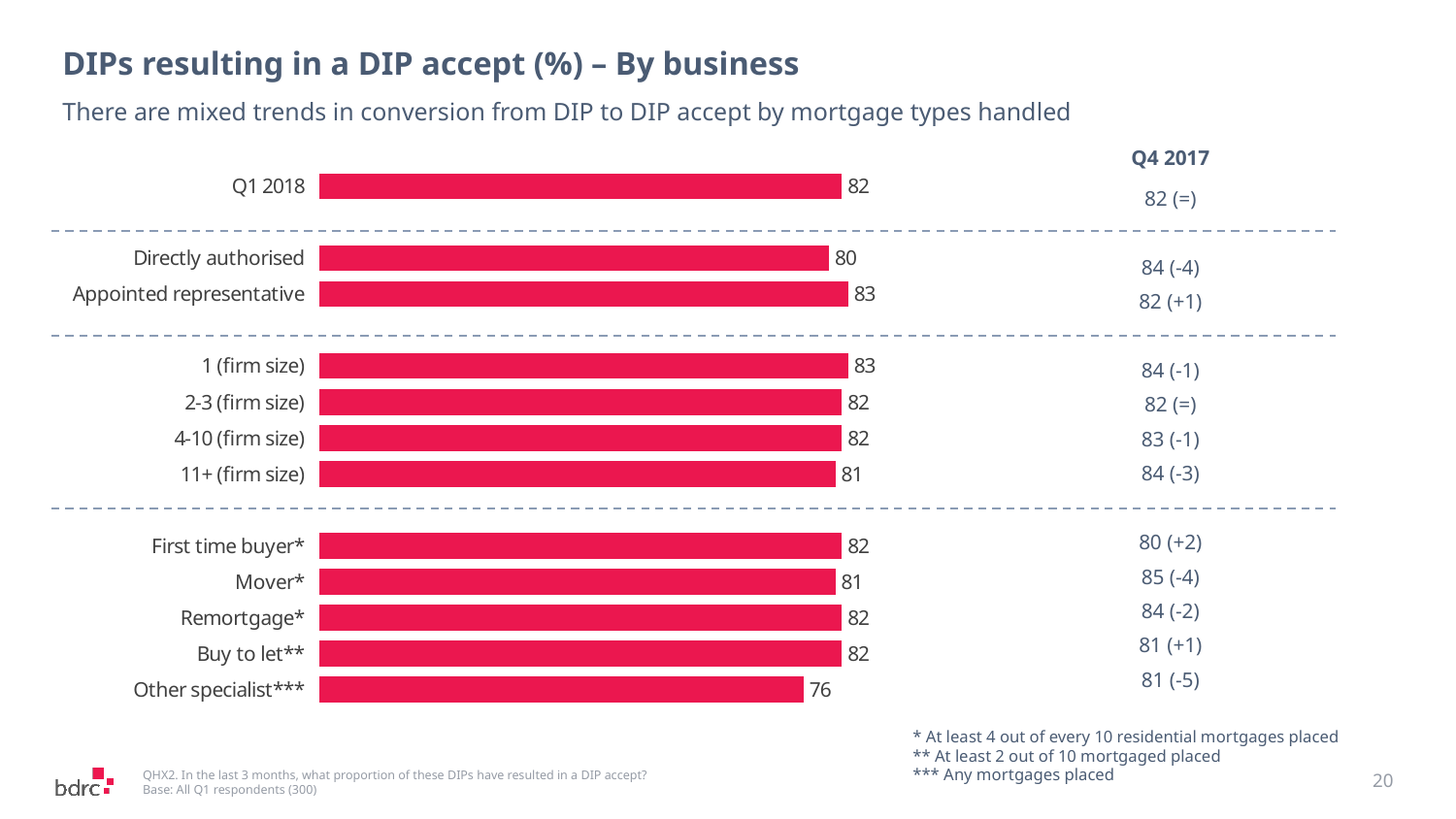
How many bars are plotted in the chart? 12 What is the value for Directly authorised? 80 Which category has the lowest value in the chart? Other specialist*** Which is larger, the value for 1 (firm size) or the value for 11+ (firm size)? 1 (firm size) What is the value for Q1 2018 overall? 82 What is the Q4 2017 value shown for Mover*? 85 (-4) What is the difference between the values for Appointed representative and Directly authorised? 3 What kind of chart is shown on the slide? Bar chart What is the value for Other specialist*** in the chart? 76 What is the value for 11+ (firm size)? 81 What is the difference between the values for First time buyer* and Other specialist***? 6 What is the value for Appointed representative? 83